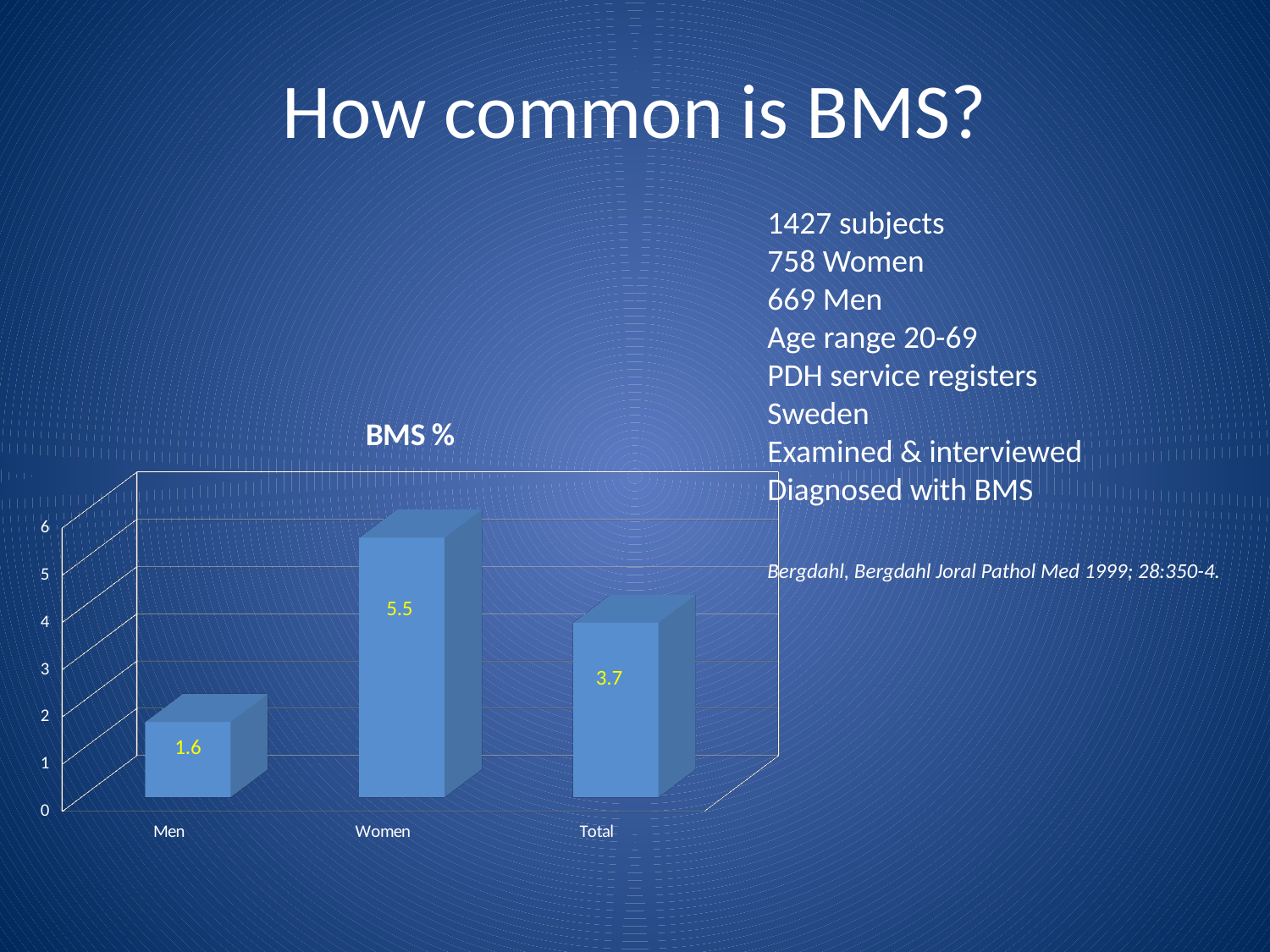
Is the BMS % value for Women greater or less than 4? greater How many categories are shown on the x axis of the chart? 3 What is the title of the chart? BMS % What is the difference between the BMS % for Women and for Total? 1.8 What is the BMS % value for Men? 1.6 Which category has the lowest BMS %? Men What kind of chart is shown on the slide? bar chart What is the BMS % value for Total? 3.7 Which category has the highest BMS %? Women What is the difference between the BMS % for Women and for Men? 3.9 What is the BMS % value for Women? 5.5 Which is larger, the BMS % for Total or for Men? Total